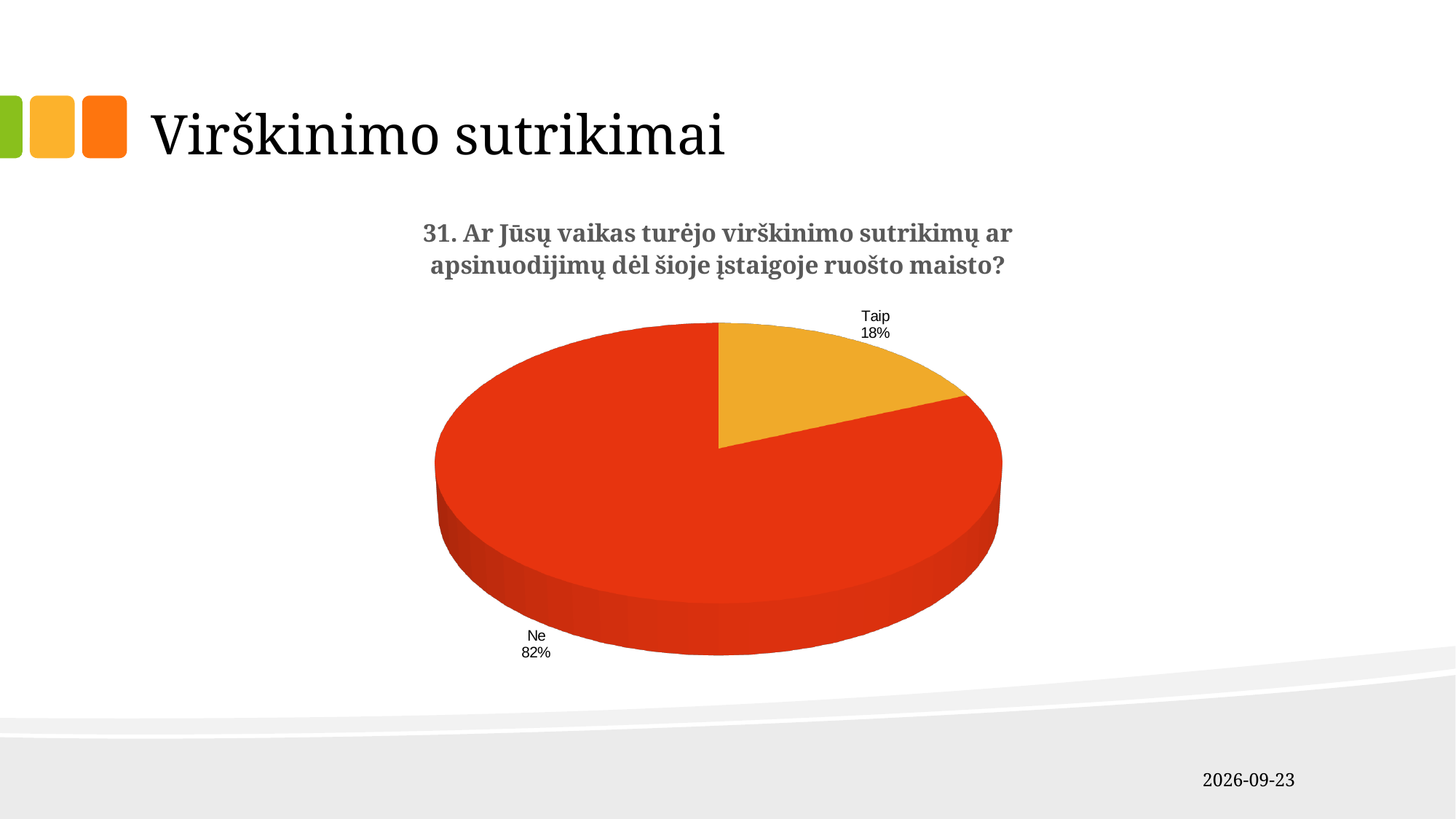
Which slice is the smallest in the pie chart? Taip Which slice is the largest in the pie chart? Ne What is the total of the two slice percentages shown on the pie chart? 100% What is the title of the chart? 31. Ar Jūsų vaikas turėjo virškinimo sutrikimų ar apsinuodijimų dėl šioje įstaigoje ruošto maisto? What colour is the "Taip" slice of the pie chart? orange-yellow How many slices does the pie chart have? 2 What is the difference in percentage points between the "Ne" and "Taip" slices? 64 Which is larger, the "Taip" slice or the "Ne" slice? Ne What share of the pie does the "Ne" slice represent? 82% What kind of chart is shown on the slide? pie chart What share of the pie does the "Taip" slice represent? 18%